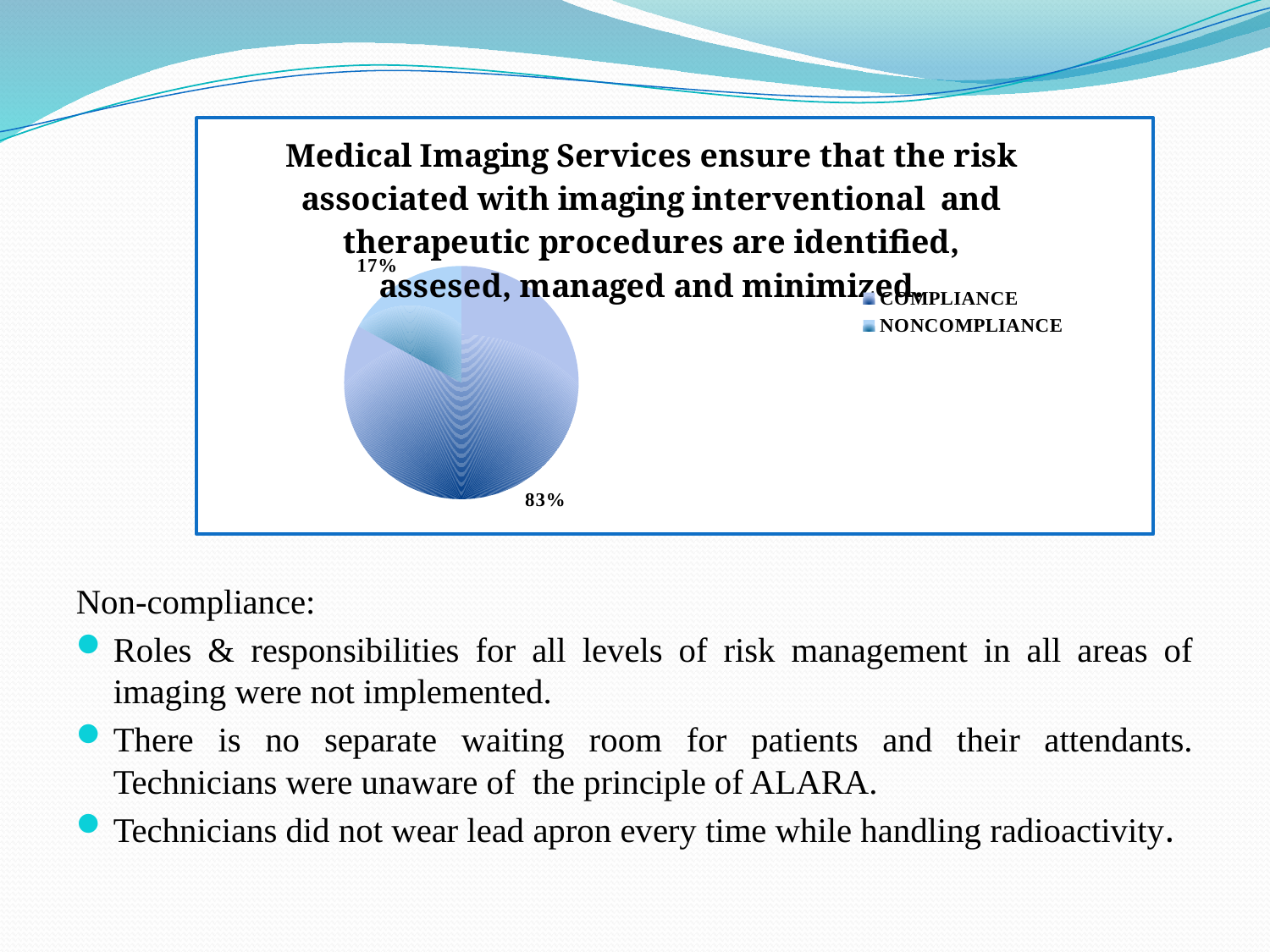
How many slices does the pie chart have? 2 Which category has the smallest slice of the pie? NONCOMPLIANCE Which category has the largest slice of the pie? COMPLIANCE What is the total of the two pie slice percentages? 100% What is the difference in percentage points between the COMPLIANCE and NONCOMPLIANCE slices? 66 What share of the pie does COMPLIANCE represent? 83% Is the NONCOMPLIANCE share greater or less than 50%? less What share of the pie does NONCOMPLIANCE represent? 17% What kind of chart is shown on the slide? pie chart What are the two legend entries of the pie chart? COMPLIANCE and NONCOMPLIANCE Which is larger, the COMPLIANCE slice or the NONCOMPLIANCE slice? COMPLIANCE How many entries does the chart legend list? 2